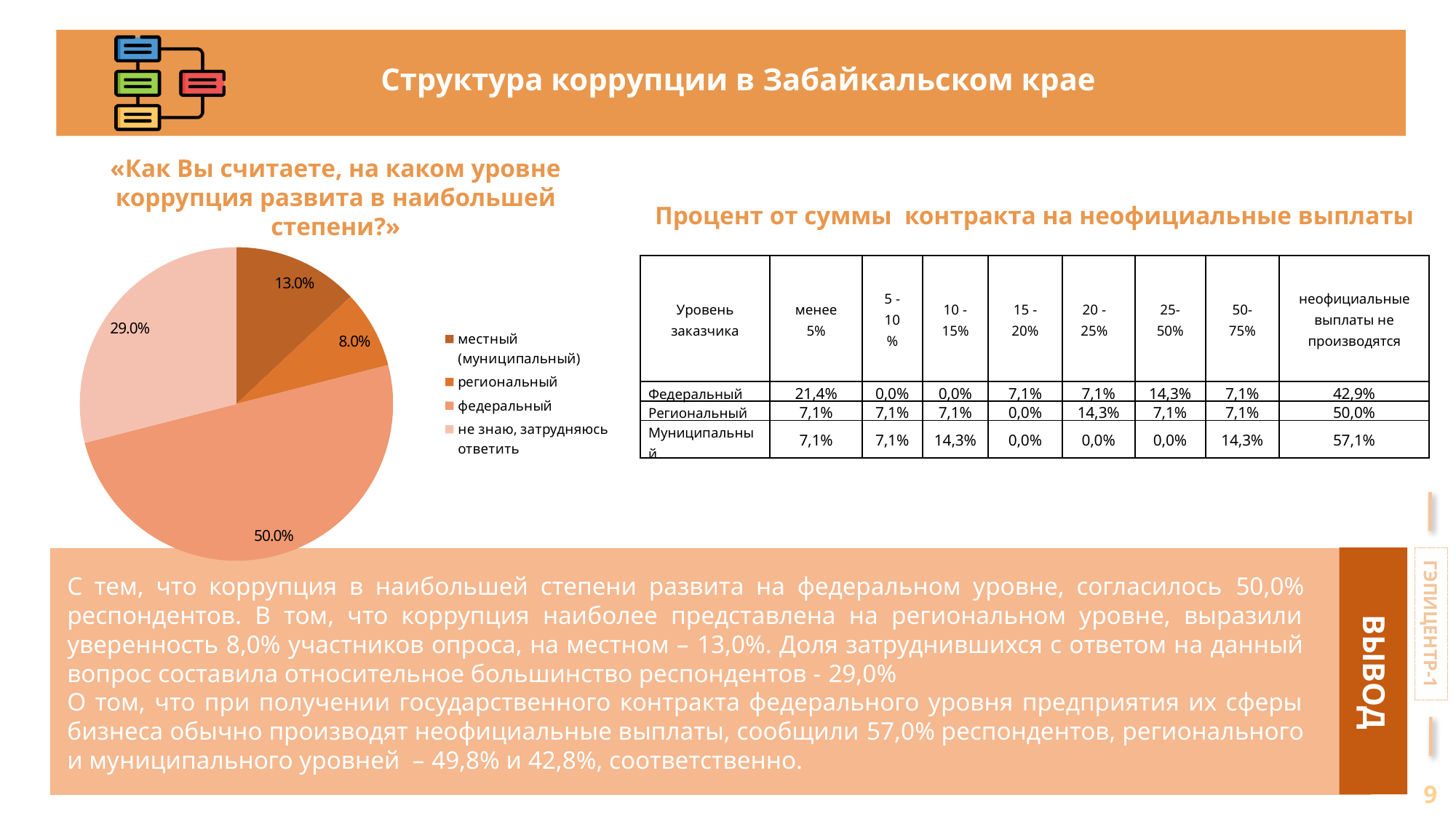
In the pie chart, what share of respondents chose «региональный»? 8.0% How many slices does the pie chart have? 4 Which category has the smallest slice in the pie chart? региональный What is the title of the pie chart? «Как Вы считаете, на каком уровне коррупция развита в наибольшей степени?» In the pie chart, what share of respondents chose «федеральный»? 50.0% In the pie chart, what is the difference between the «федеральный» and «не знаю, затрудняюсь ответить» shares? 21.0% How many entries does the pie chart legend list? 4 What kind of chart is shown on the left of the slide? pie chart In the pie chart, what share of respondents chose «местный (муниципальный)»? 13.0% Which category has the largest slice in the pie chart? федеральный In the pie chart, what share of respondents chose «не знаю, затрудняюсь ответить»? 29.0% In the pie chart, which is larger: «местный (муниципальный)» or «региональный»? местный (муниципальный)